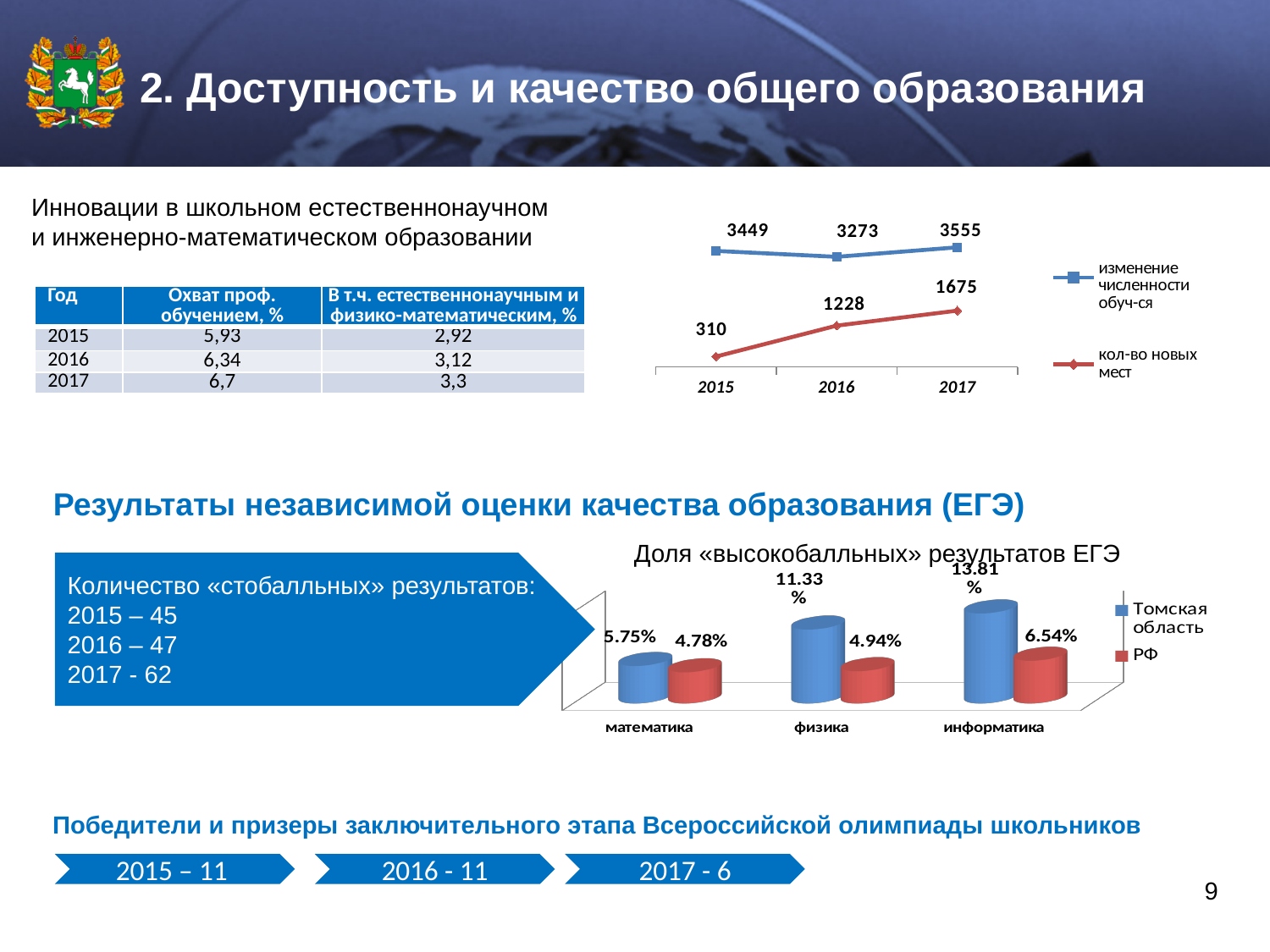
In the line chart at the top right of the slide, in which year is «изменение численности обуч-ся» lowest? 2016 In the chart «Доля «высокобалльных» результатов ЕГЭ», which is larger in физика: Томская область or РФ? Томская область In the chart «Доля «высокобалльных» результатов ЕГЭ», what is the difference between Томская область and РФ in математика? 0.97% In the line chart at the top right of the slide, how many series does the legend list? 2 In the chart «Доля «высокобалльных» результатов ЕГЭ», what is the value for РФ in информатика? 6.54% In the line chart at the top right of the slide, what is the difference between «кол-во новых мест» in 2017 and in 2016? 447 In the chart «Доля «высокобалльных» результатов ЕГЭ», which subject has the highest value for Томская область? информатика In the line chart at the top right of the slide, what is the value of «кол-во новых мест» for 2015? 310 What kind of chart is «Доля «высокобалльных» результатов ЕГЭ»? bar chart In the line chart at the top right of the slide, what is the value of «изменение численности обуч-ся» for 2017? 3555 In the line chart at the top right of the slide, does «кол-во новых мест» rise or fall from 2015 to 2017? rise In the chart «Доля «высокобалльных» результатов ЕГЭ», what is the value for Томская область in физика? 11.33%